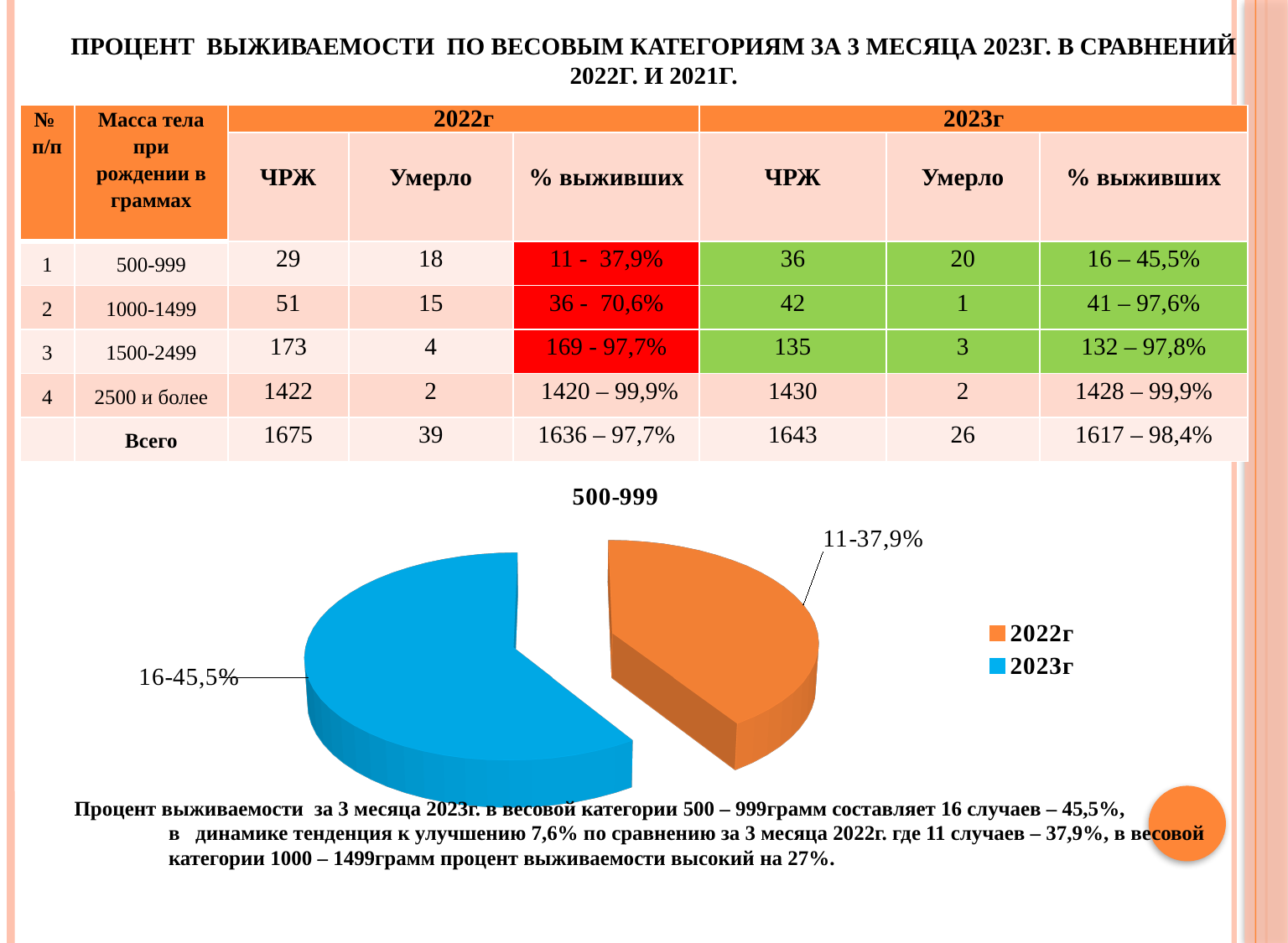
What is the title of the pie chart? 500-999 How many series does the legend of the pie chart list? 2 What data label is shown on the 2023г slice of the pie chart? 16-45,5% What is the difference between the percentages shown in the pie chart labels for 2023г (45,5%) and 2022г (37,9%)? 7,6% What data label is shown on the 2022г slice of the pie chart? 11-37,9% Which slice of the pie chart is larger, 2022г or 2023г? 2023г Which series has the smallest slice in the pie chart? 2022г By how many cases does the 2023г count (16) in the pie chart labels exceed the 2022г count (11)? 5 How many slices does the pie chart have? 2 Which series has the largest slice in the pie chart? 2023г What kind of chart is shown below the table on the slide? pie chart What colour is the 2023г slice in the pie chart? blue